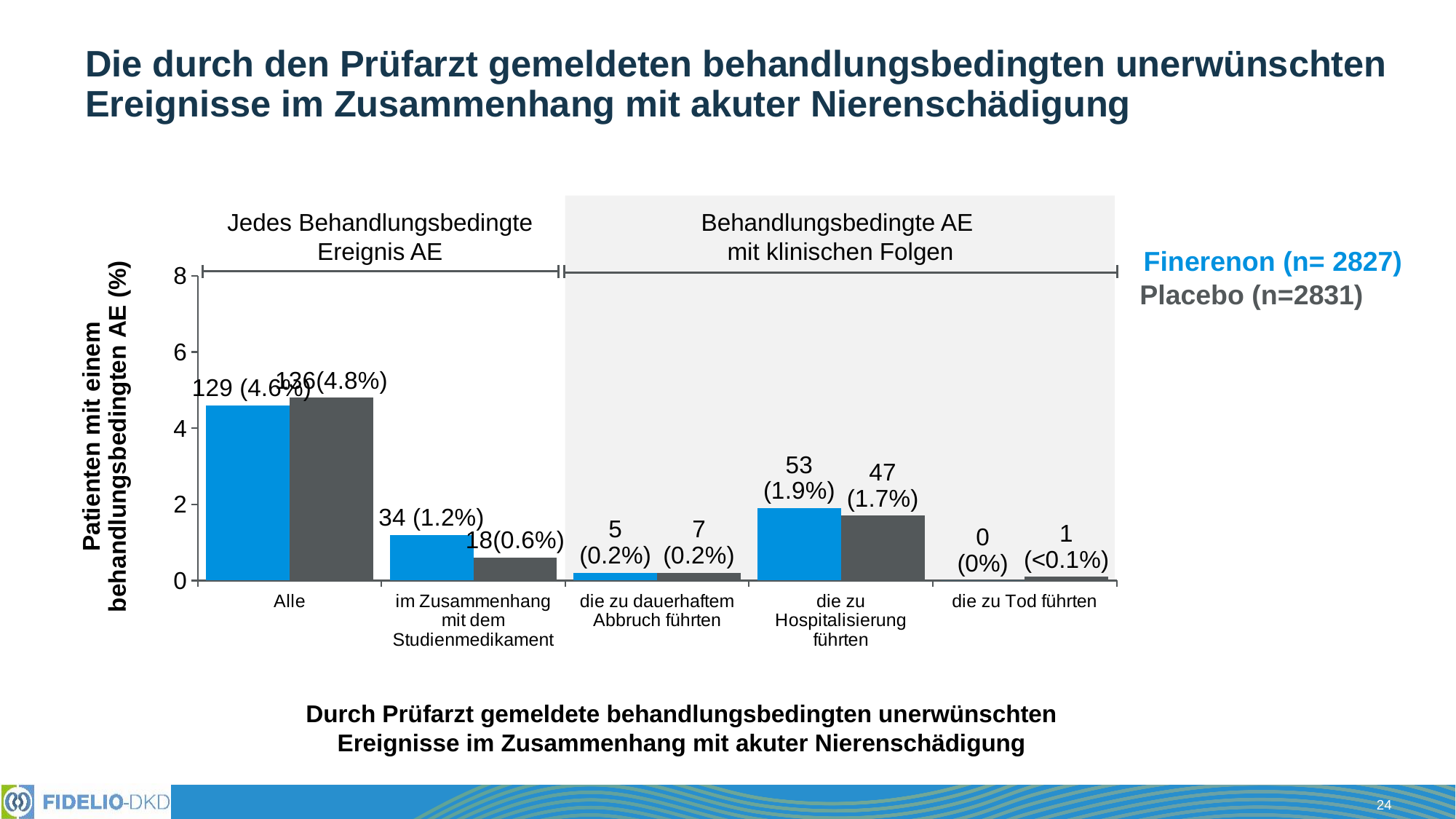
How many series does the legend list? 2 Which category has the highest value for Finerenon? Alle What is the value for Placebo in the category 'die zu Tod führten'? 1 (<0.1%) What is the value for Finerenon in the category 'im Zusammenhang mit dem Studienmedikament'? 34 (1.2%) What is the difference in patient counts between Finerenon and Placebo in the category 'im Zusammenhang mit dem Studienmedikament'? 16 In the category 'die zu Hospitalisierung führten', which is larger, Finerenon or Placebo? Finerenon What kind of chart is shown on the slide? bar chart What is the value for Finerenon in the category 'die zu Hospitalisierung führten'? 53 (1.9%) Which category has the lowest value for Finerenon? die zu Tod führten What is the value for Placebo in the category 'im Zusammenhang mit dem Studienmedikament'? 18(0.6%) How many categories are shown on the x axis? 5 What is the value for Placebo in the category 'Alle'? 136(4.8%)